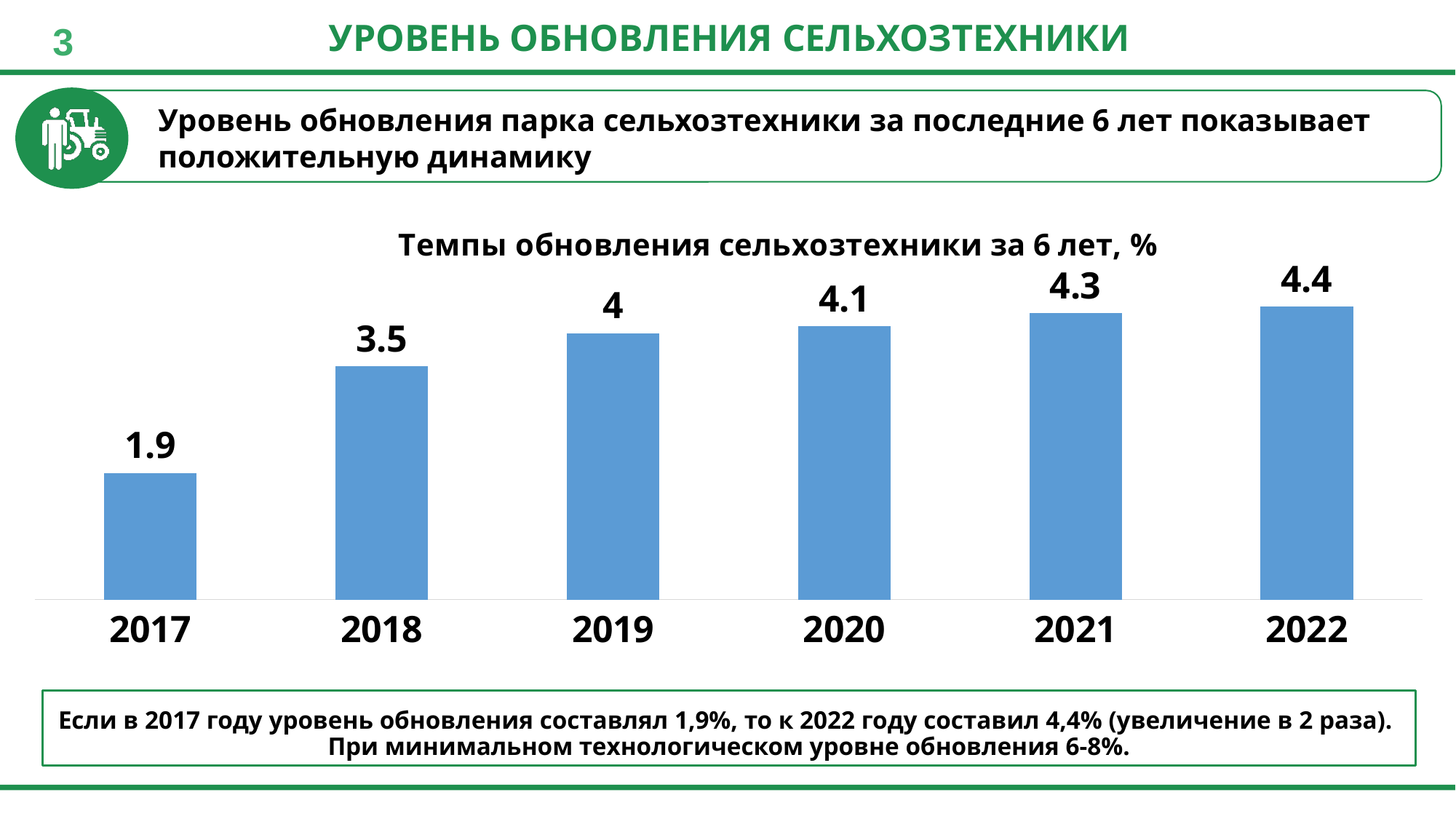
What is the difference between the values for 2018 and 2017? 1.6 Which year has the lowest value? 2017 Which year has the highest value? 2022 How many years are shown on the chart? 6 What is the difference between the values for 2022 and 2017? 2.5 What kind of chart is this? bar chart What is the value for 2017? 1.9 Do the values rise or fall from 2017 to 2022? rise What is the title of the chart? Темпы обновления сельхозтехники за 6 лет, % Which is larger, the value for 2018 or the value for 2020? 2020 What is the value for 2019? 4 What is the value for 2022? 4.4